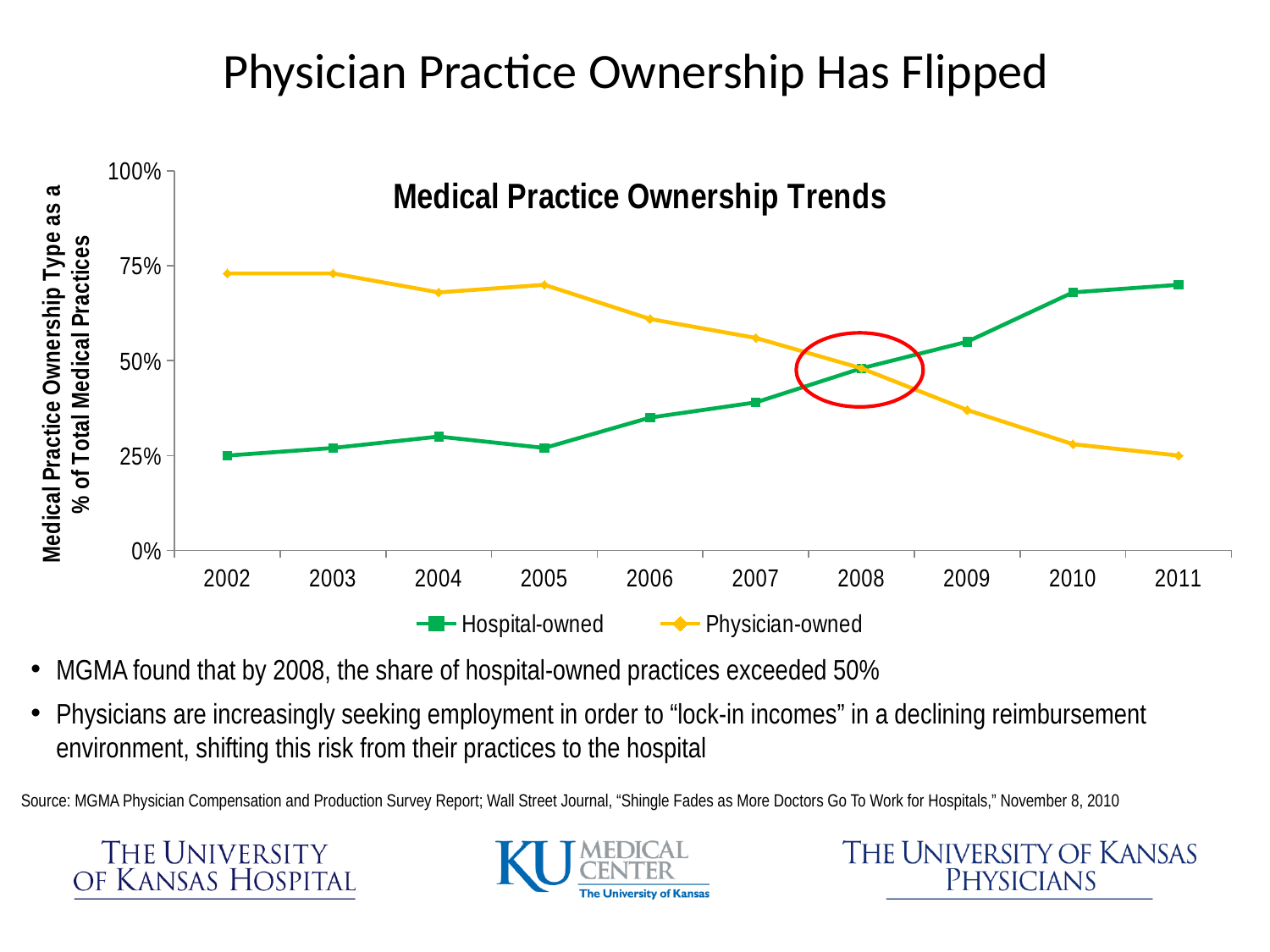
What kind of chart is shown on the slide? Line chart Does the Hospital-owned series rise or fall from 2002 to 2011? Rise Is the value for Hospital-owned in 2011 greater or less than 50%? greater Which two series are listed in the chart's legend? Hospital-owned and Physician-owned In 2011, which series has the larger value, Hospital-owned or Physician-owned? Hospital-owned How many series does the chart's legend list? 2 In 2002, which series has the larger value, Hospital-owned or Physician-owned? Physician-owned What is the title of the chart? Medical Practice Ownership Trends How many years are plotted along the x axis of the chart? 10 Is the value for Hospital-owned in 2005 greater or less than 50%? less Is the value for Physician-owned in 2002 greater or less than 50%? greater Does the Physician-owned series rise or fall from 2002 to 2011? Fall